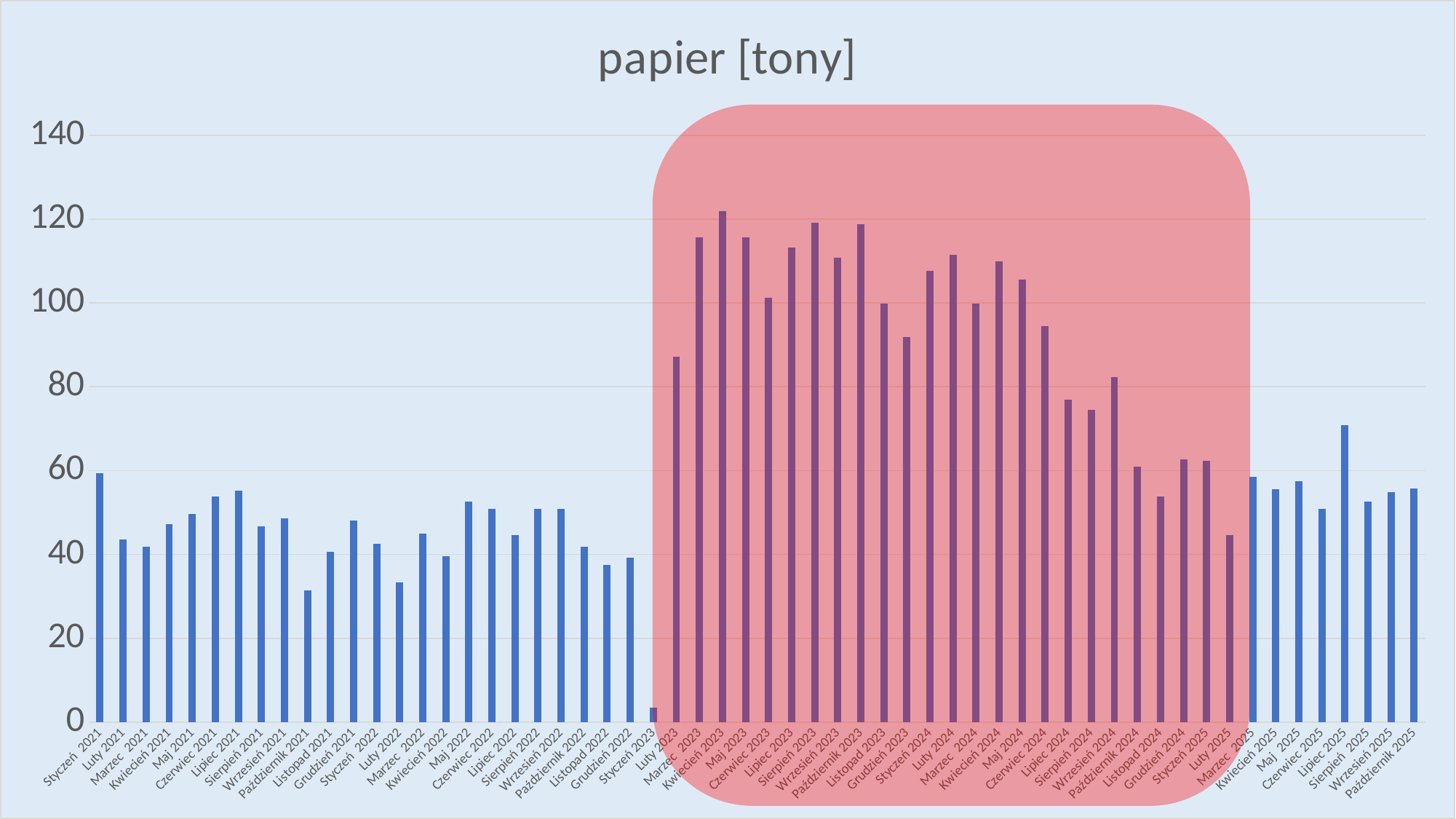
Is the value for Sierpień 2025 greater or less than 60? less What is the title of the chart? papier [tony] What colour is the shaded region highlighting the 2023–2025 bars? red Do the values generally rise or fall from Styczeń 2024 to Grudzień 2024? fall Is the value for Marzec 2023 greater or less than 100? greater Which month has the highest value in the chart? Kwiecień 2023 What kind of chart is shown on the slide? bar chart Which is larger, the value for Sierpień 2025 or the value for Lipiec 2025? Lipiec 2025 Which month has the lowest value in the chart? Styczeń 2023 Is the value for Luty 2023 greater or less than 20? greater